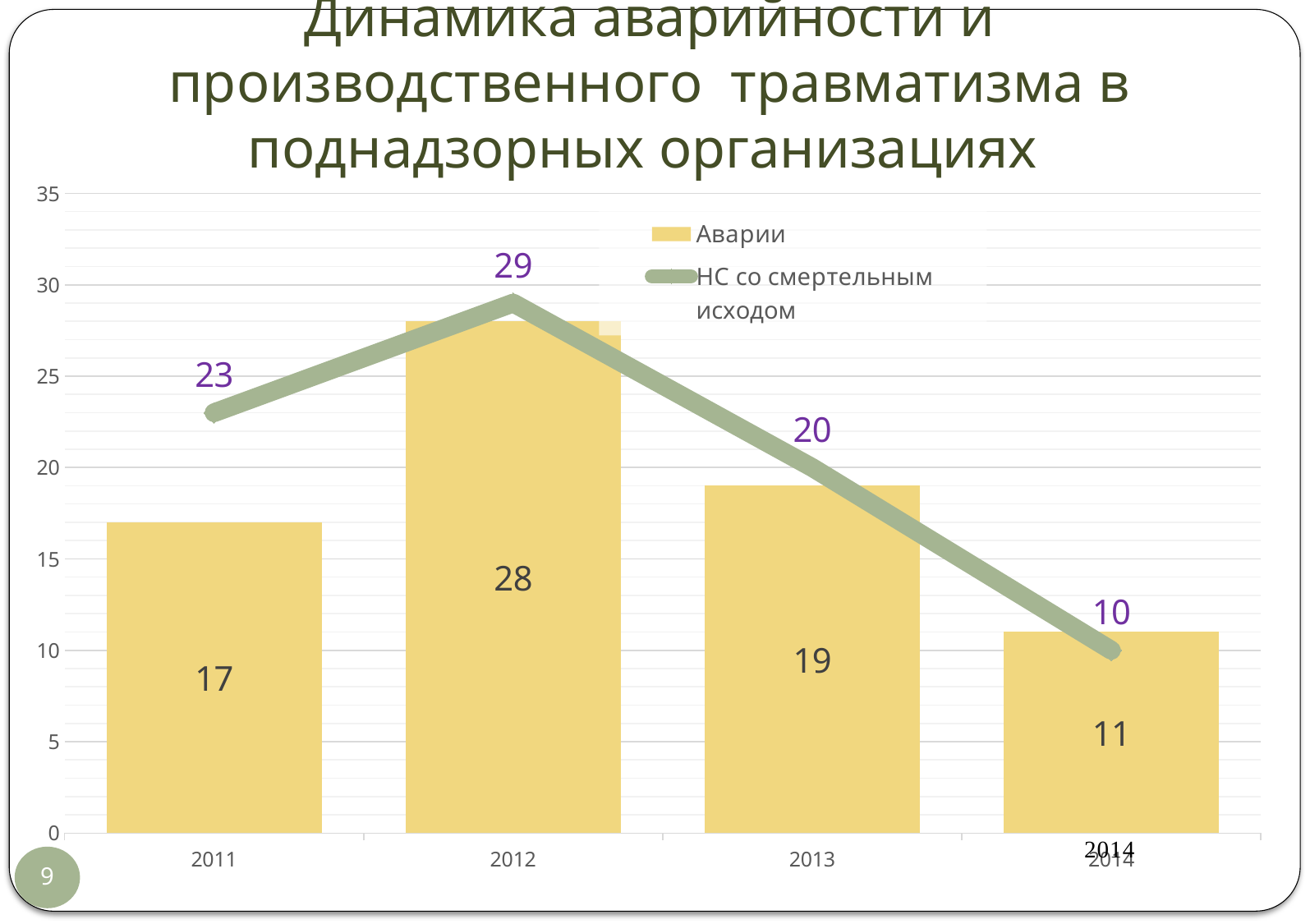
Which is larger in 2011: Аварии or НС со смертельным исходом? НС со смертельным исходом Which year has the lowest value for НС со смертельным исходом? 2014 What is the value of Аварии for 2014? 11 Do the values of НС со смертельным исходом rise or fall from 2012 to 2014? fall Which series is drawn as a line rather than bars? НС со смертельным исходом What is the value of НС со смертельным исходом for 2011? 23 How many years are shown on the x axis? 4 Which year has the highest value for Аварии? 2012 How many series does the legend list? 2 What is the value of НС со смертельным исходом for 2013? 20 What is the value of Аварии for 2012? 28 What is the difference between the Аварии values for 2012 and 2014? 17